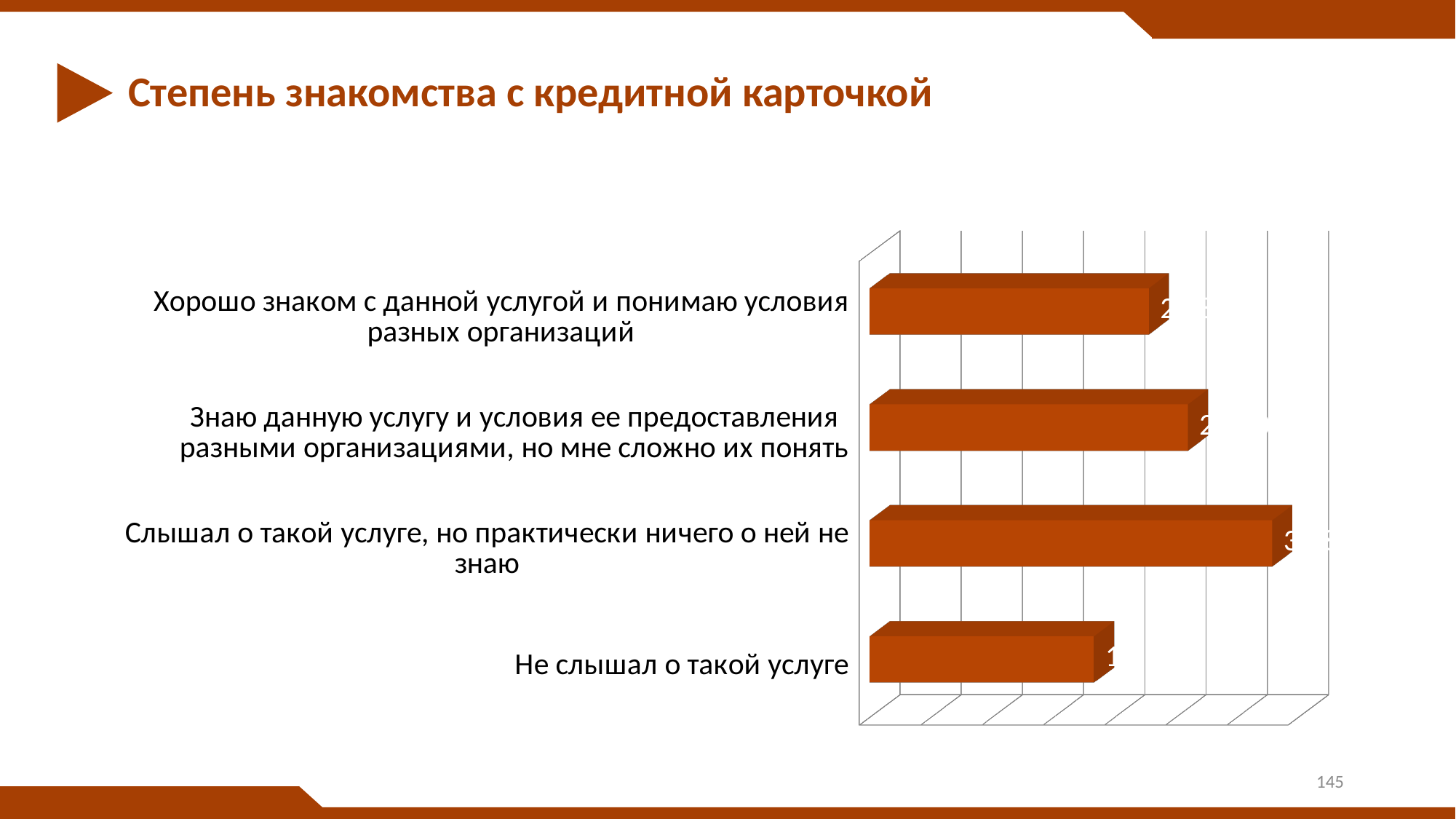
Which is larger: the value for "Знаю данную услугу и условия ее предоставления разными организациями, но мне сложно их понять" or the value for "Хорошо знаком с данной услугой и понимаю условия разных организаций"? Знаю данную услугу и условия ее предоставления разными организациями, но мне сложно их понять Which is larger: the value for "Слышал о такой услуге, но практически ничего о ней не знаю" or the value for "Знаю данную услугу и условия ее предоставления разными организациями, но мне сложно их понять"? Слышал о такой услуге, но практически ничего о ней не знаю What kind of chart is shown on the slide? Bar chart How many categories does the chart show? 4 What is the title of the slide containing the chart? Степень знакомства с кредитной карточкой What colour are the bars in the chart? Orange-brown Which is larger: the value for "Хорошо знаком с данной услугой и понимаю условия разных организаций" or the value for "Не слышал о такой услуге"? Хорошо знаком с данной услугой и понимаю условия разных организаций Which category has the highest value? Слышал о такой услуге, но практически ничего о ней не знаю Which category is listed at the bottom of the chart? Не слышал о такой услуге Which category has the lowest value? Не слышал о такой услуге